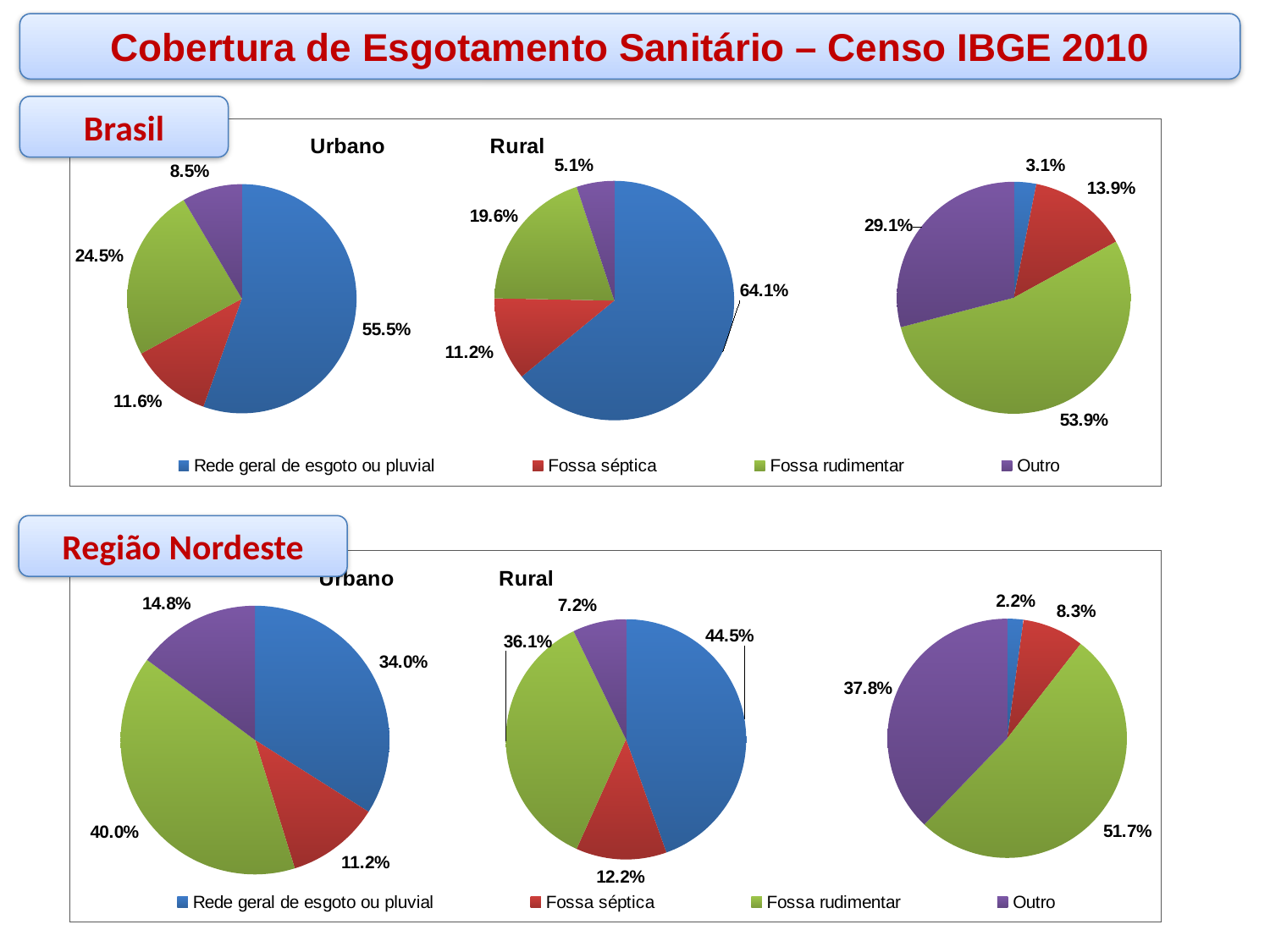
In the Brasil panel, which category has the smallest slice in the right pie chart? Rede geral de esgoto ou pluvial In the Brasil panel, is the Outro slice larger in the left pie chart or in the middle pie chart? Left pie chart In the Brasil panel, which category has the largest slice in the middle pie chart? Rede geral de esgoto ou pluvial What type of charts are shown on the slide? Pie charts In the Região Nordeste panel, what is the difference between the Fossa rudimentar and Rede geral de esgoto ou pluvial shares in the left pie chart? 6.0% In the Região Nordeste panel, which category has the largest slice in the left pie chart? Fossa rudimentar In the Região Nordeste panel, what is the share of Fossa séptica in the middle pie chart? 12.2% In the Brasil panel, what is the share of Fossa rudimentar in the right pie chart? 53.9% How many pie charts are shown on the slide in total? 6 In the Região Nordeste panel, what is the share of Outro in the right pie chart? 37.8% In the Brasil panel, what is the share of Rede geral de esgoto ou pluvial in the left pie chart? 55.5% How many series does the legend of the Brasil panel list? 4